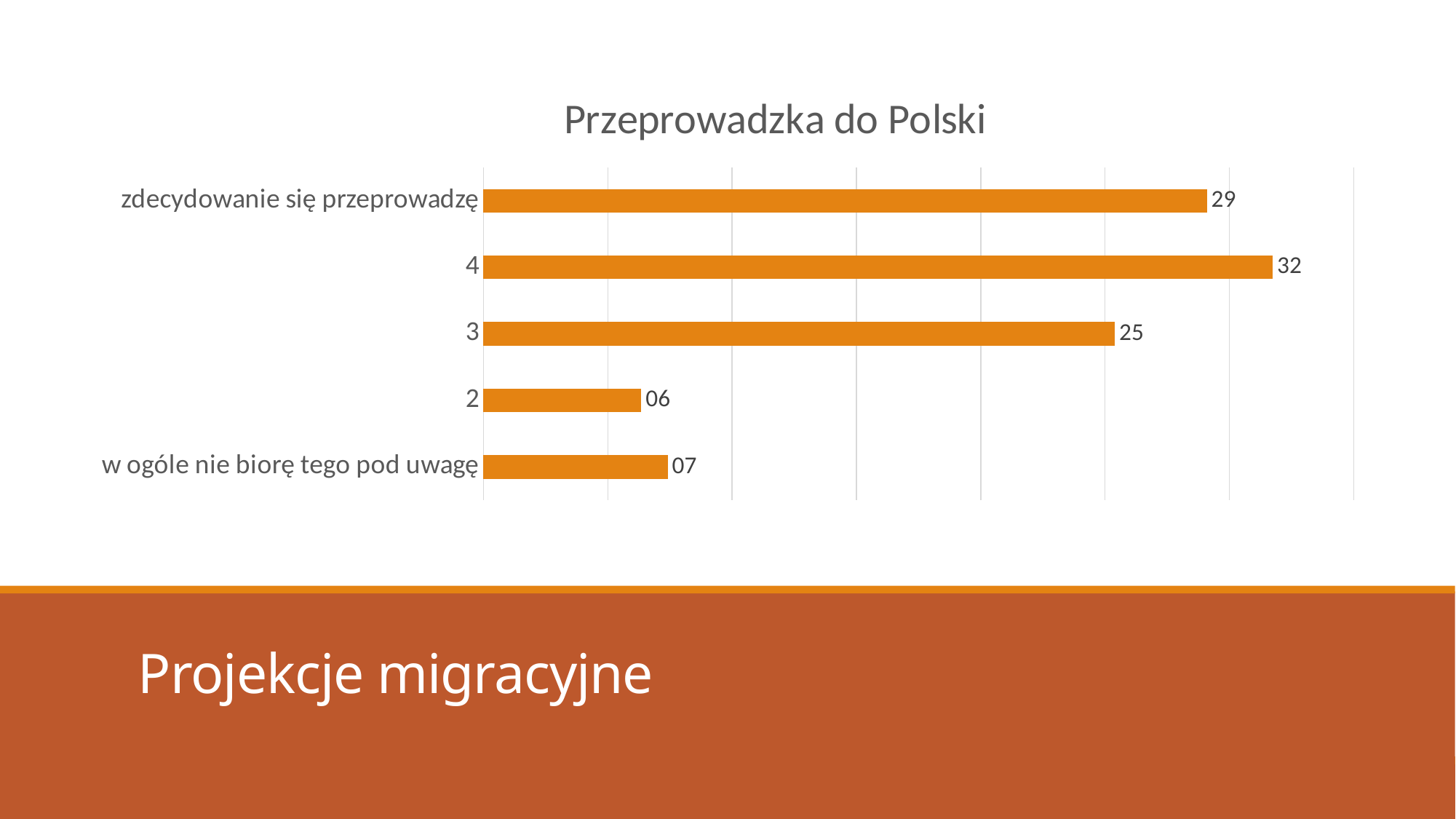
Which category has the lowest value? 2 What is the value for category "3"? 25 What is the value for category "2"? 06 What kind of chart is shown on the slide? bar chart Which is larger: the value for "zdecydowanie się przeprowadzę" or the value for category "3"? zdecydowanie się przeprowadzę Which category has the highest value? 4 What is the difference between the values for category "4" and category "3"? 7 What is the value for category "4"? 32 How many categories are shown in the chart? 5 What is the title of the chart? Przeprowadzka do Polski What is the value for "zdecydowanie się przeprowadzę"? 29 What is the value for "w ogóle nie biorę tego pod uwagę"? 07